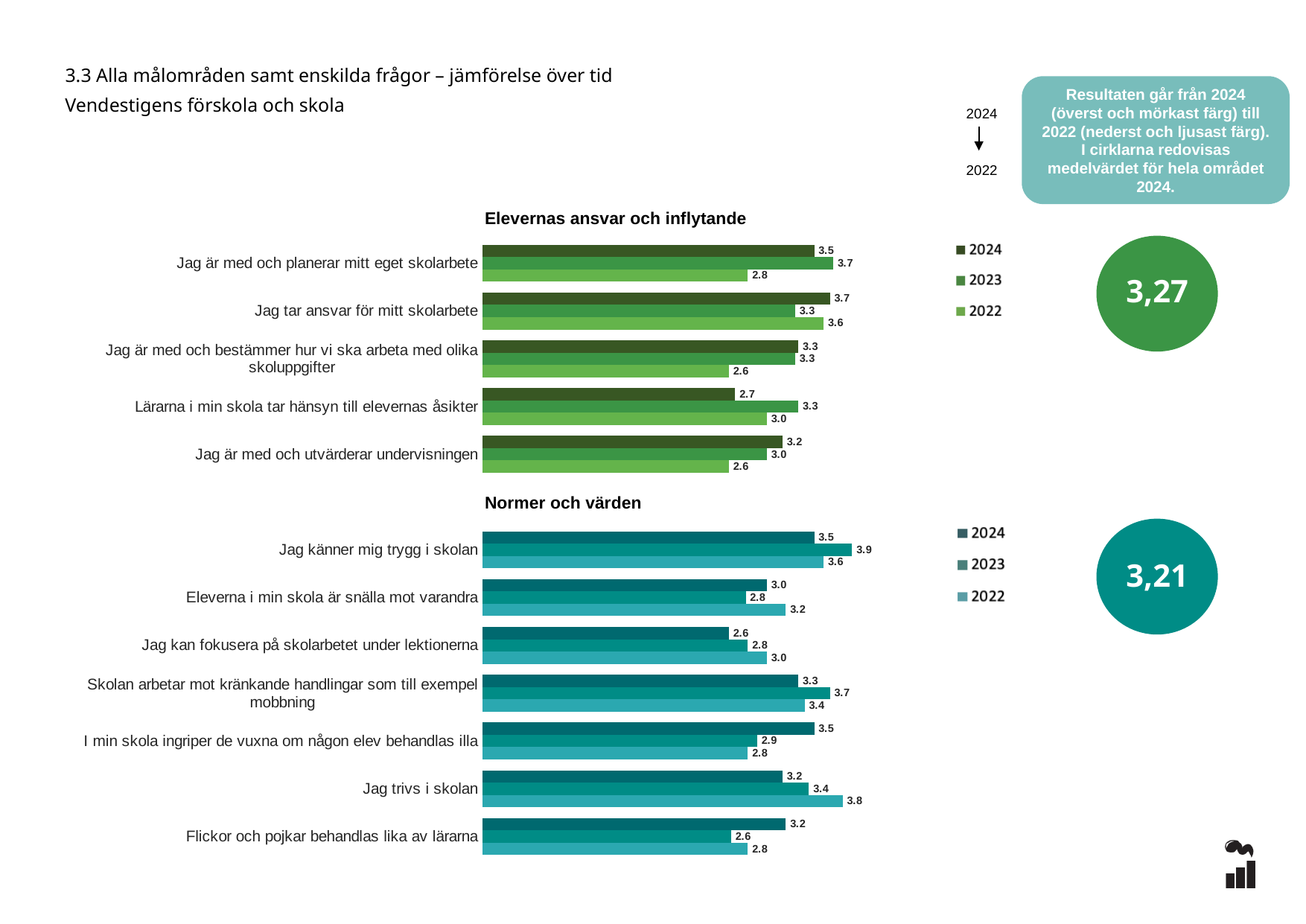
In the 'Normer och värden' chart, which is larger for 'Jag trivs i skolan': the 2024 value or the 2022 value? 2022 In the 'Elevernas ansvar och inflytande' chart, what is the difference between the 2023 and 2022 values for 'Jag är med och planerar mitt eget skolarbete'? 0.9 In the 'Normer och värden' chart, how many series does the legend list? 3 In the 'Elevernas ansvar och inflytande' chart, how many categories are shown? 5 What type of chart is used for 'Elevernas ansvar och inflytande'? Bar chart In the 'Elevernas ansvar och inflytande' chart, what is the 2024 value for 'Jag tar ansvar för mitt skolarbete'? 3.7 In the 'Normer och värden' chart, which category has the lowest 2024 value? Jag kan fokusera på skolarbetet under lektionerna In the 'Elevernas ansvar och inflytande' chart, what is the 2022 value for 'Jag är med och planerar mitt eget skolarbete'? 2.8 In the 'Normer och värden' chart, what is the difference between the 2024 and 2023 values for 'I min skola ingriper de vuxna om någon elev behandlas illa'? 0.6 In the 'Elevernas ansvar och inflytande' chart, which category has the lowest 2024 value? Lärarna i min skola tar hänsyn till elevernas åsikter In the 'Normer och värden' chart, how many categories are shown? 7 In the 'Normer och värden' chart, what is the 2023 value for 'Jag känner mig trygg i skolan'? 3.9